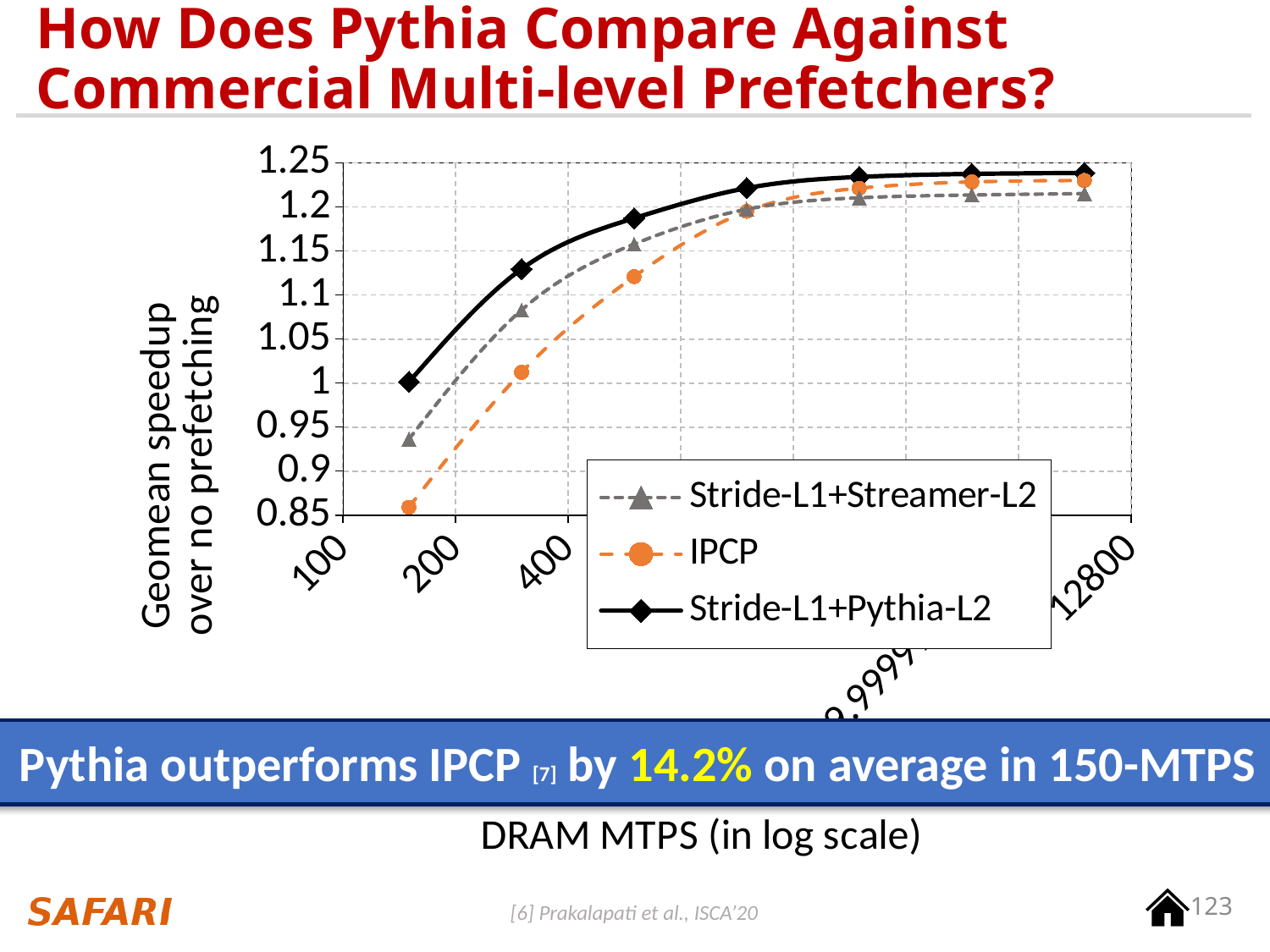
What kind of chart is shown on the slide? line chart Is the leftmost value of the IPCP series greater or less than 0.9? less At the second data point from the left, which series has the larger value: IPCP or Stride-L1+Streamer-L2? Stride-L1+Streamer-L2 Is the leftmost value of the Stride-L1+Streamer-L2 series greater or less than 0.95? less Is the second-from-left value of the Stride-L1+Pythia-L2 series greater or less than 1.1? greater Which series has the lowest value at the leftmost data point of the chart? IPCP Do the values of the Stride-L1+Pythia-L2 series rise or fall as DRAM MTPS increases along the x axis? rise Which series has the highest value at the leftmost data point of the chart? Stride-L1+Pythia-L2 How many series does the chart's legend list? 3 What is the x-axis title of the chart? DRAM MTPS (in log scale) Which series is drawn as a solid black line in the chart? Stride-L1+Pythia-L2